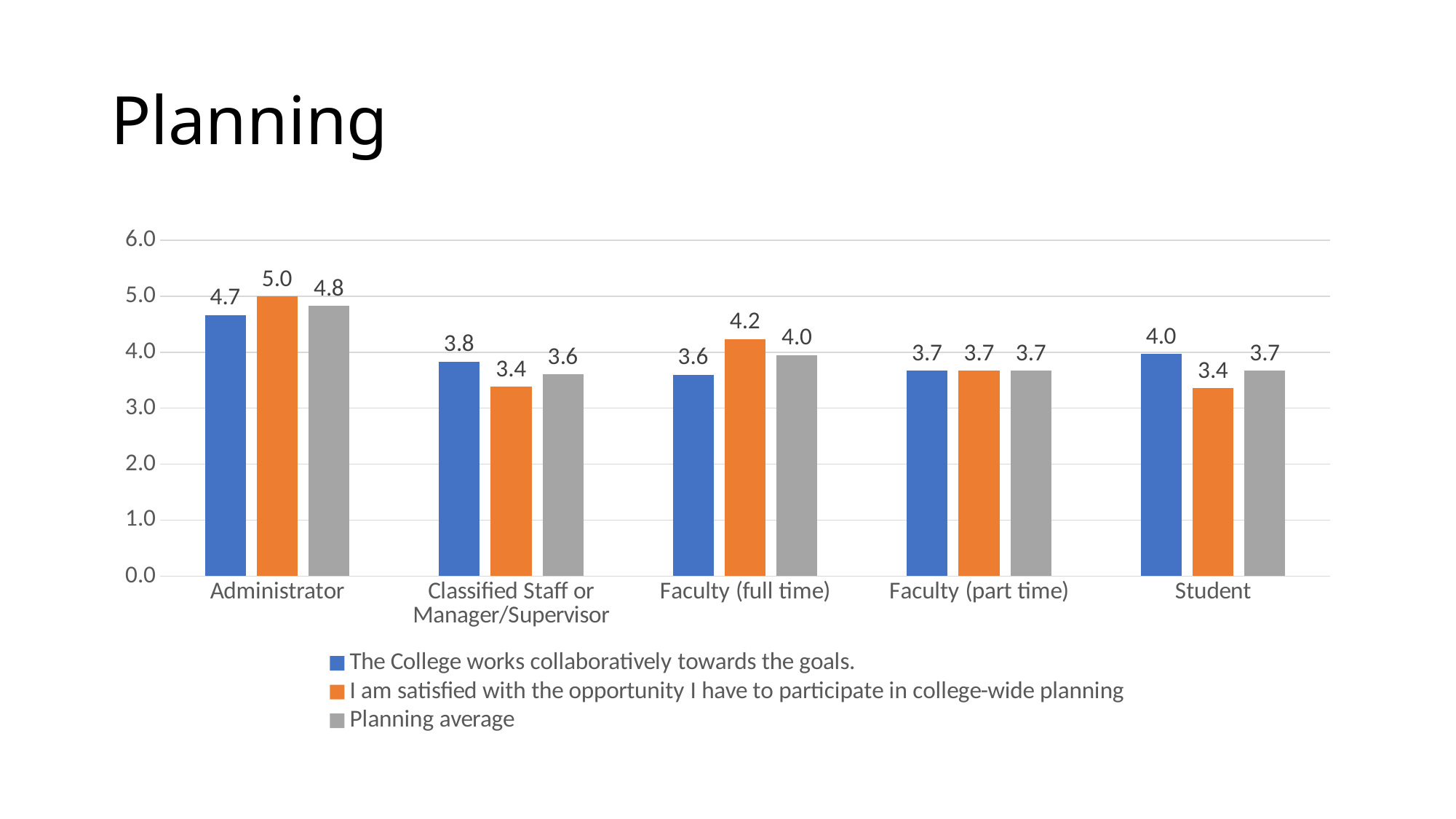
What is the value for Student in the series "The College works collaboratively towards the goals."? 4.0 Which category has the lowest value for "The College works collaboratively towards the goals."? Faculty (full time) What is the difference between the Administrator and Student values for "I am satisfied with the opportunity I have to participate in college-wide planning"? 1.6 For Classified Staff or Manager/Supervisor, which is larger: "The College works collaboratively towards the goals." or "I am satisfied with the opportunity I have to participate in college-wide planning"? The College works collaboratively towards the goals. How many series does the legend list? 3 How many categories are shown on the x axis? 5 What kind of chart is shown on the slide? Bar chart What is the Planning average value for Faculty (full time)? 4.0 Which category has the highest Planning average? Administrator What is the value for Administrator in the series "I am satisfied with the opportunity I have to participate in college-wide planning"? 5.0 What is the title of the slide? Planning Is the Planning average for Administrator greater or less than 4.0? greater